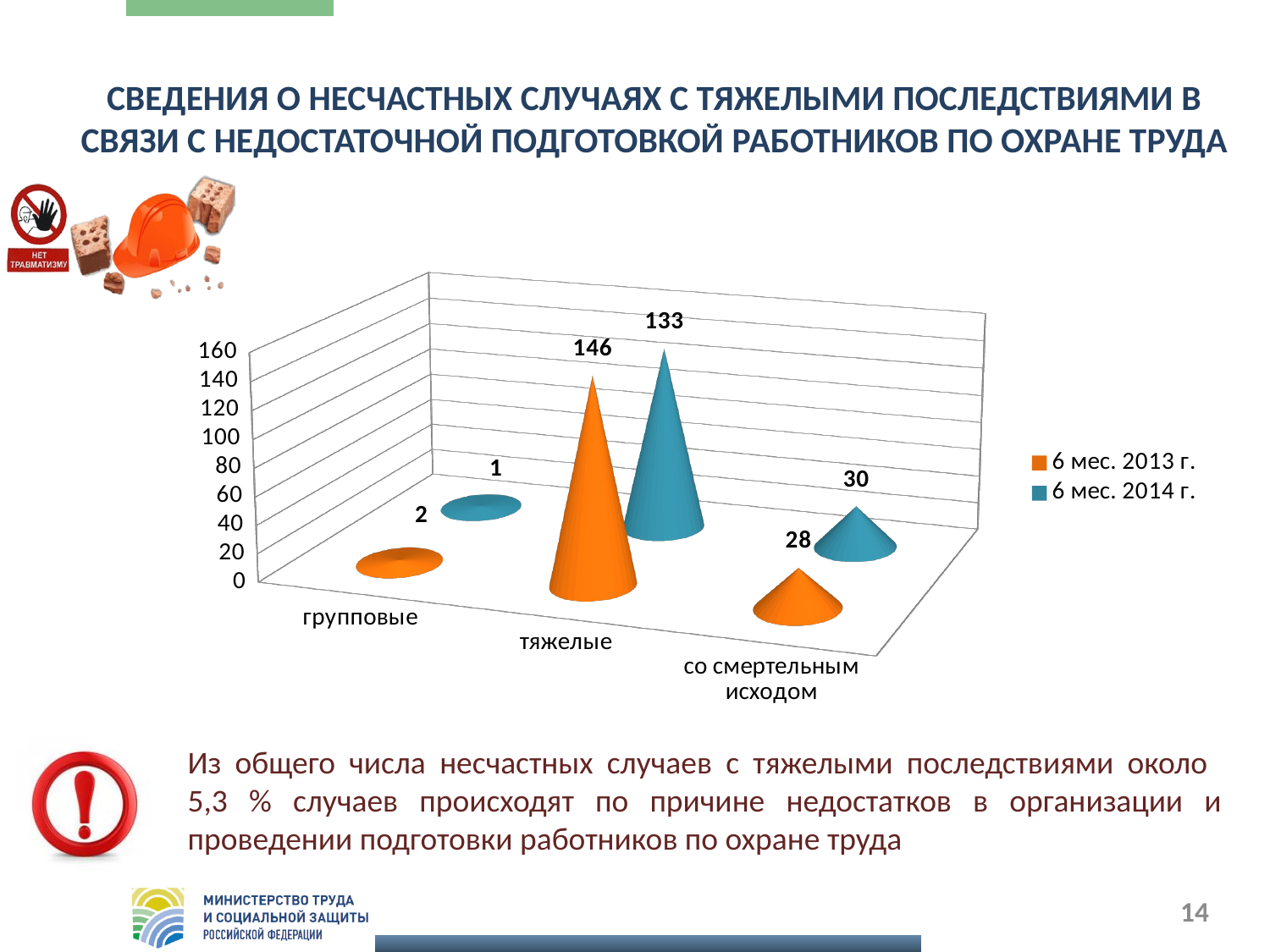
Which category has the highest value in the 6 мес. 2013 г. series? тяжелые What is the value for групповые in the 6 мес. 2013 г. series? 2 How many series does the chart legend list? 2 Which colour represents the 6 мес. 2014 г. series in the chart? blue What is the difference between the 6 мес. 2013 г. and 6 мес. 2014 г. values for тяжелые? 13 How many categories are shown on the x axis of the chart? 3 Which category has the lowest value in the 6 мес. 2014 г. series? групповые What kind of chart is shown on the slide? bar chart What is the value for со смертельным исходом in the 6 мес. 2014 г. series? 30 What is the value for тяжелые in the 6 мес. 2013 г. series? 146 For со смертельным исходом, which series has the larger value: 6 мес. 2013 г. or 6 мес. 2014 г.? 6 мес. 2014 г. What is the value for тяжелые in the 6 мес. 2014 г. series? 133